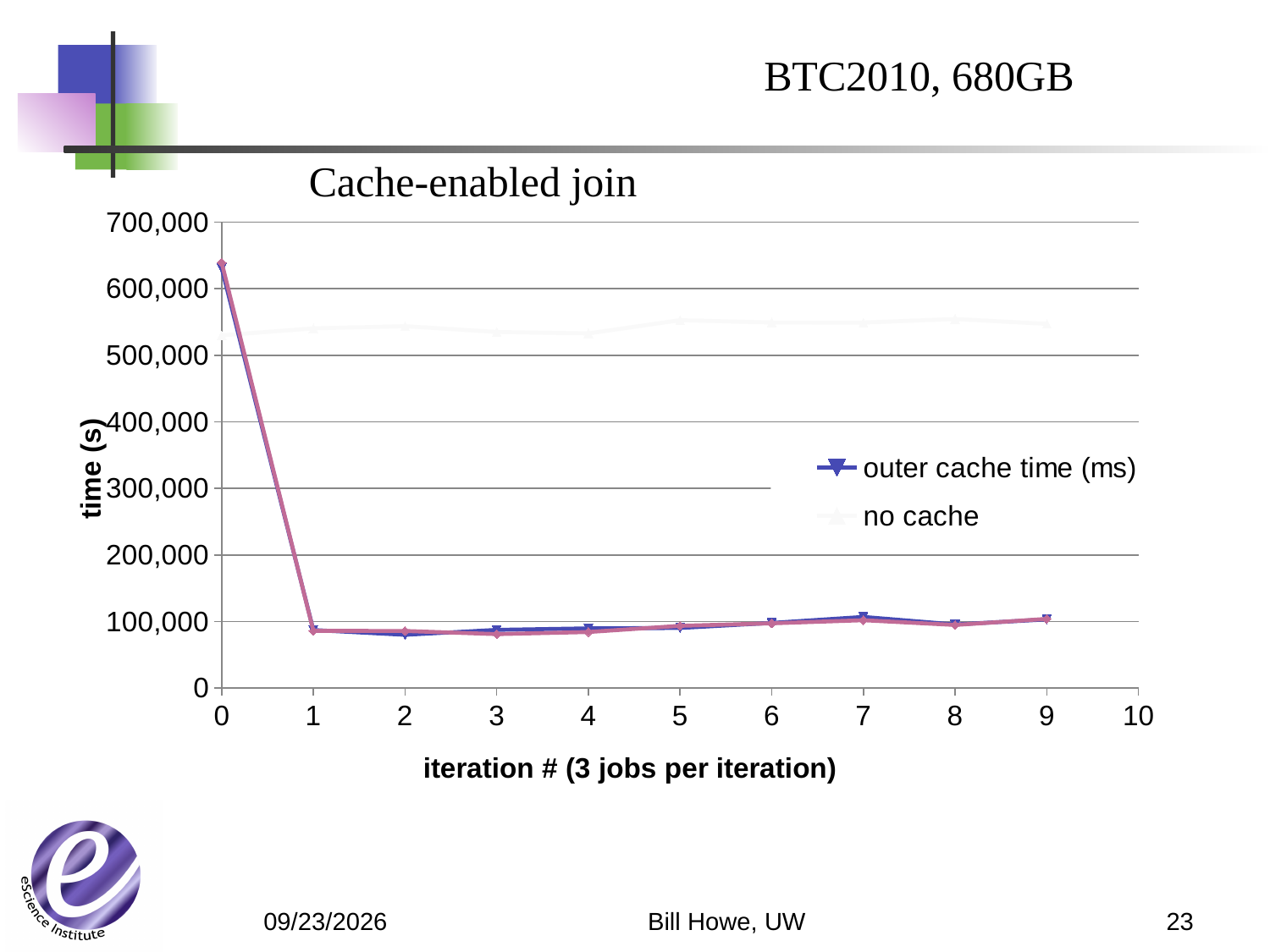
How many series does the legend list? 2 What kind of chart is shown on the slide? line chart How many data points are plotted for the outer cache time series? 10 How does the outer cache time change from iteration 0 to iteration 1? It falls sharply At which iteration is the outer cache time highest? 0 What is the title of the chart? Cache-enabled join Is the outer cache time at iteration 1 greater or less than 200,000? less Is the outer cache time at iteration 0 greater or less than 600,000? greater What is the label of the x axis? iteration # (3 jobs per iteration) At iteration 3, which series has the larger value, outer cache time (ms) or no cache? no cache Is the outer cache time at iteration 7 greater or less than 200,000? less